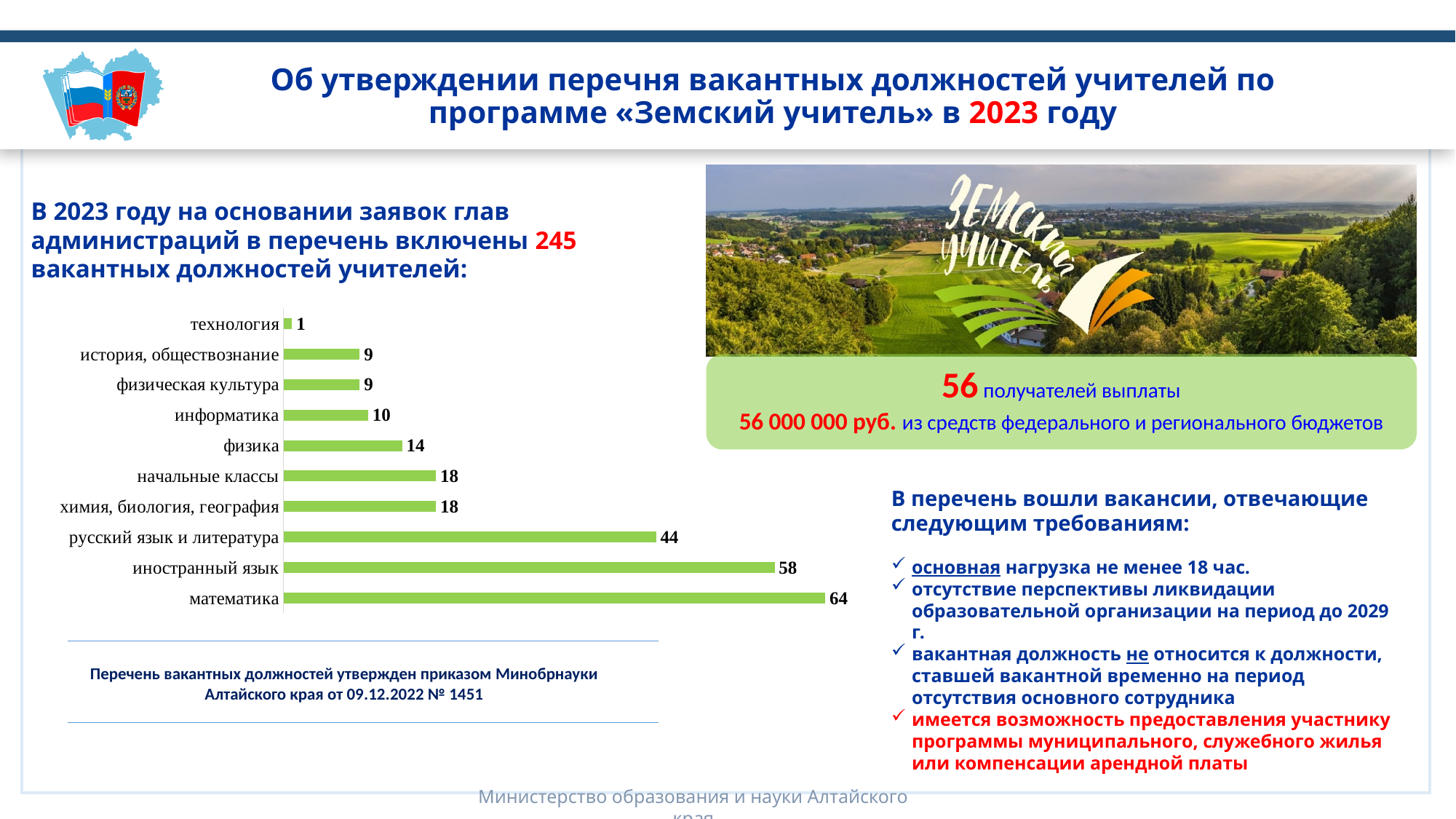
Which is larger, the value for физика or the value for информатика? физика What is the value for русский язык и литература? 44 How many categories are shown in the chart? 10 What is the value for информатика? 10 What is the difference between the values for русский язык и литература and начальные классы? 26 Which category has the lowest value? технология What is the value for физика? 14 What kind of chart is shown on the slide? bar chart What is the value for иностранный язык? 58 What is the value for математика? 64 What is the difference between the values for математика and иностранный язык? 6 Which category has the highest value? математика